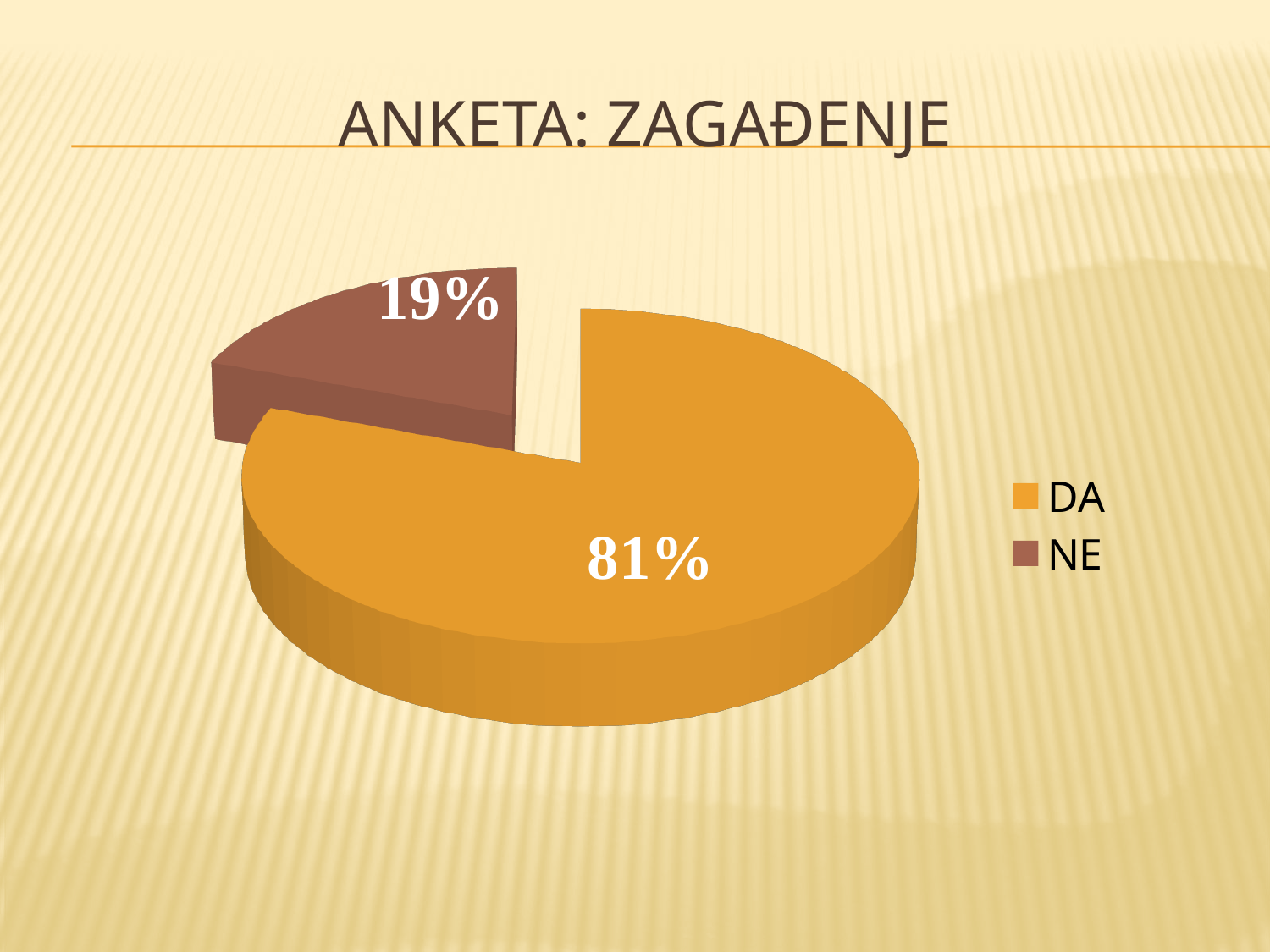
How many categories are shown in the pie chart? 2 Which category has the largest slice of the pie? DA Which slice is larger, DA or NE? DA What is the difference in percentage points between the DA and NE slices? 62 What kind of chart is shown on the slide? Pie chart What colour is the NE slice in the pie chart? Brown What share of the pie does the DA slice represent? 81% What share of the pie does the NE slice represent? 19% What is the title of the slide? ANKETA: ZAGAĐENJE Which category has the smallest slice of the pie? NE